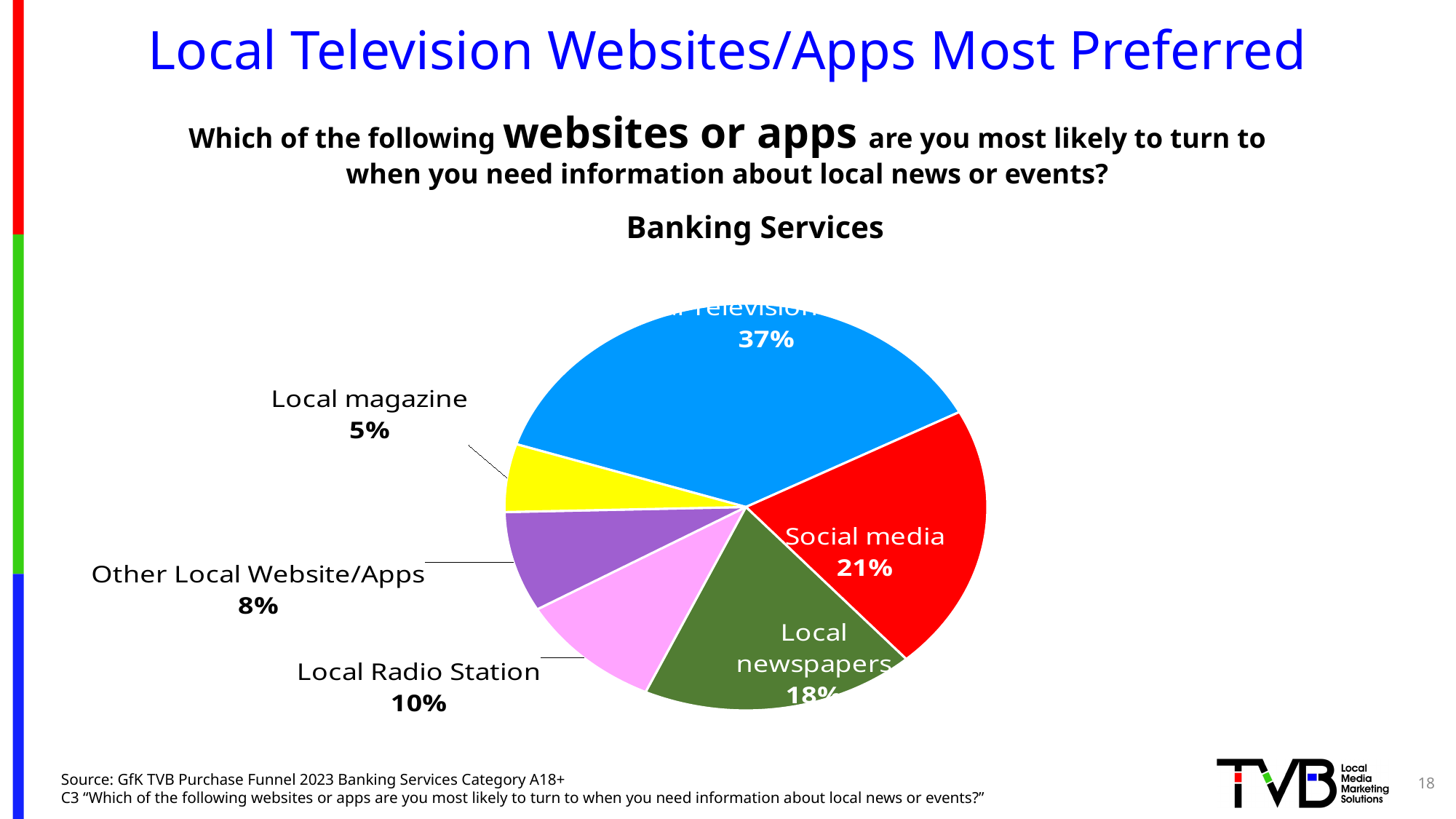
Which category has the smallest share of the pie? Local magazine What is the title of the pie chart? Banking Services Which is larger, the share for Local Radio Station or the share for Other Local Website/Apps? Local Radio Station Which category has the largest share of the pie? Local television What percentage of respondents chose Social media? 21% How many slices does the pie chart have? 6 What percentage of respondents chose Local magazine? 5% What percentage of respondents chose Local Radio Station? 10% What type of chart is shown on the slide? Pie chart What percentage of respondents chose Other Local Website/Apps? 8% What is the difference in percentage points between Social media and Local newspapers? 3 What percentage of respondents chose Local newspapers? 18%